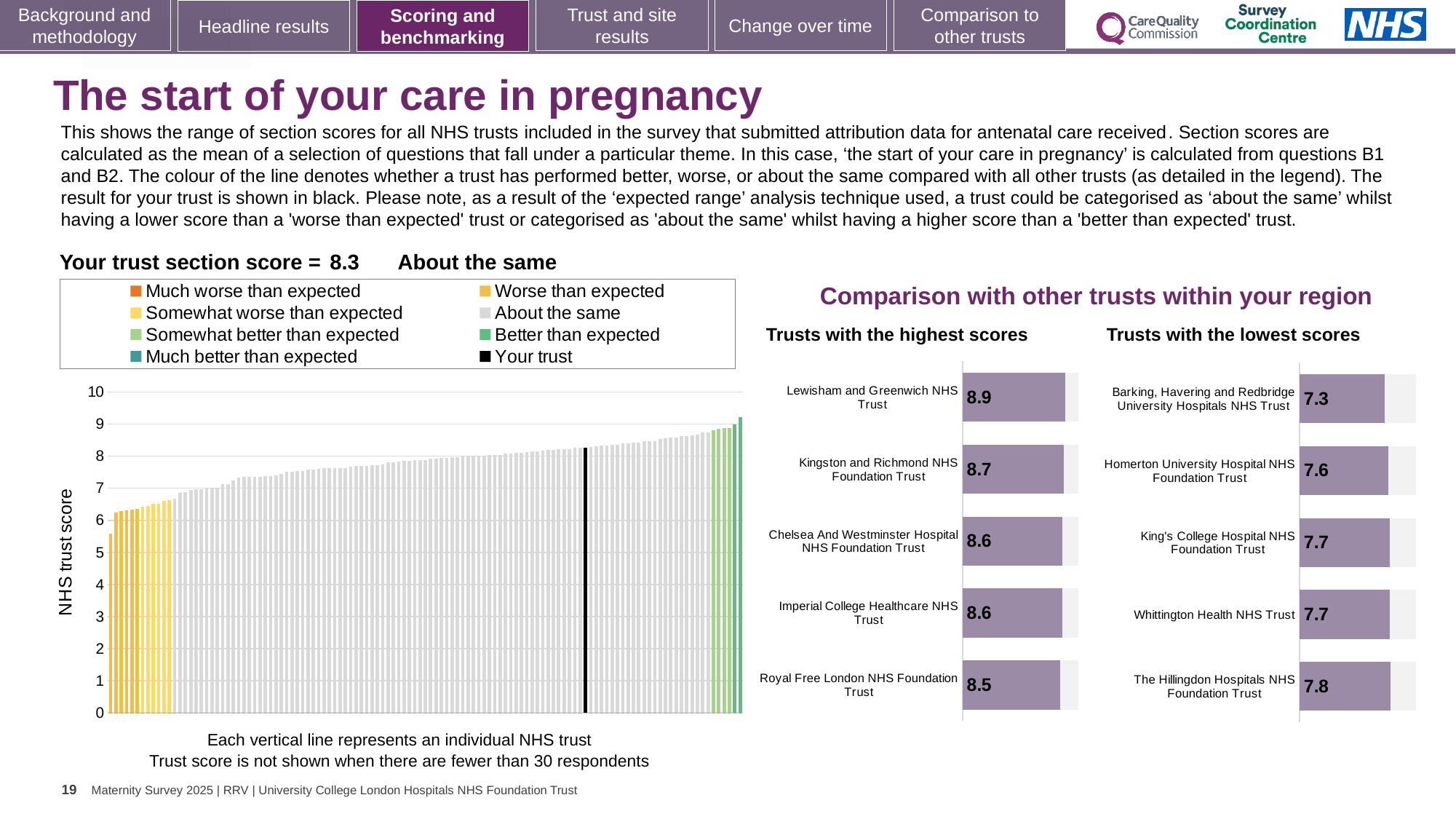
Which has the higher score: Kingston and Richmond NHS Foundation Trust in the highest scores chart or Homerton University Hospital NHS Foundation Trust in the lowest scores chart? Kingston and Richmond NHS Foundation Trust In the 'Trusts with the lowest scores' chart, what is the score for Barking, Havering and Redbridge University Hospitals NHS Trust? 7.3 In the 'Trusts with the lowest scores' chart, which trust has the lowest score? Barking, Havering and Redbridge University Hospitals NHS Trust In the 'Trusts with the lowest scores' chart, what is the score for Whittington Health NHS Trust? 7.7 In the 'Trusts with the highest scores' chart, what is the score for Lewisham and Greenwich NHS Trust? 8.9 In the 'Trusts with the highest scores' chart, what is the difference between the scores of Lewisham and Greenwich NHS Trust and Royal Free London NHS Foundation Trust? 0.4 In the large 'NHS trust score' chart, what colour is used for the bar representing 'Your trust'? Black How many trusts are shown in the 'Trusts with the highest scores' chart? 5 In the large 'NHS trust score' chart, do the bar values rise or fall from left to right? Rise In the 'Trusts with the lowest scores' chart, what is the difference between the scores of The Hillingdon Hospitals NHS Foundation Trust and Barking, Havering and Redbridge University Hospitals NHS Trust? 0.5 In the 'Trusts with the highest scores' chart, which trust has the highest score? Lewisham and Greenwich NHS Trust What kind of chart is the large 'NHS trust score' chart on the left of the slide? Bar chart